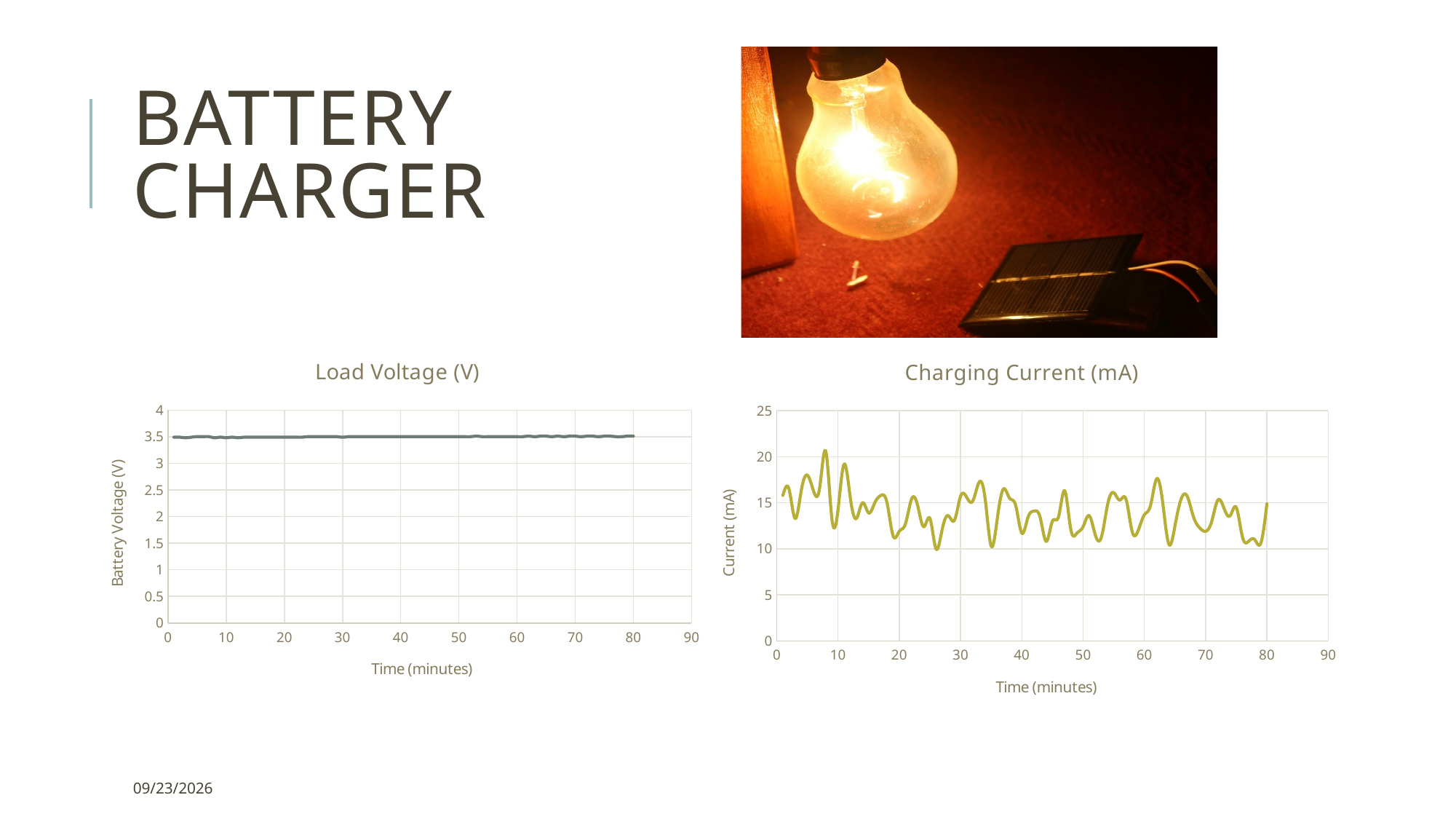
In the Charging Current (mA) chart, is the current at 20 minutes greater or less than 15? less In the Load Voltage (V) chart, does the battery voltage rise, fall, or stay roughly constant over time? stays roughly constant In the Charging Current (mA) chart, is the current at 50 minutes greater or less than 20? less What is the label of the horizontal axis in the Load Voltage (V) chart? Time (minutes) What is the label of the vertical axis in the Charging Current (mA) chart? Current (mA) In the Load Voltage (V) chart, is the battery voltage at 40 minutes greater or less than 3? greater How many charts are shown on the slide? 2 What kind of chart is the Charging Current (mA) chart? line chart What kind of chart is the Load Voltage (V) chart? line chart